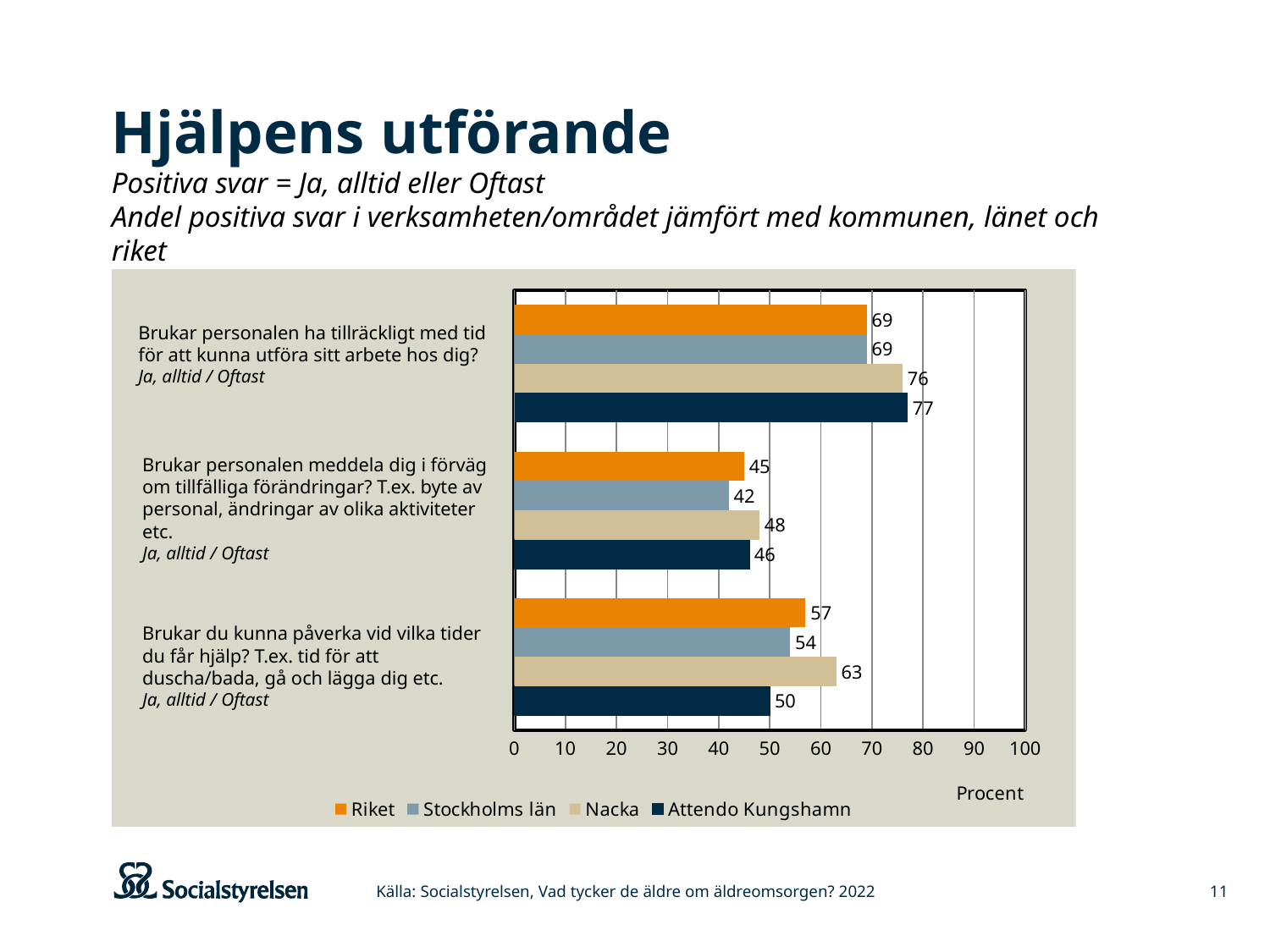
What is the value for Nacka on the question "Brukar du kunna påverka vid vilka tider du får hjälp?"? 63 How many series does the legend list? 4 Which series has the highest value on the question "Brukar du kunna påverka vid vilka tider du får hjälp?"? Nacka On the question "Brukar du kunna påverka vid vilka tider du får hjälp?", which is larger: Riket or Attendo Kungshamn? Riket What is the difference between Nacka and Riket on the question "Brukar personalen ha tillräckligt med tid för att kunna utföra sitt arbete hos dig?"? 7 What unit is shown on the horizontal axis of the chart? Procent How many questions (categories) are shown in the chart? 3 What is the value for Attendo Kungshamn on the question "Brukar personalen ha tillräckligt med tid för att kunna utföra sitt arbete hos dig?"? 77 What kind of chart is shown on the slide? Bar chart Is the value for Attendo Kungshamn on the question "Brukar personalen meddela dig i förväg om tillfälliga förändringar?" greater or less than 50? less Which series has the lowest value on the question "Brukar personalen meddela dig i förväg om tillfälliga förändringar?"? Stockholms län What is the value for Stockholms län on the question "Brukar personalen meddela dig i förväg om tillfälliga förändringar?"? 42